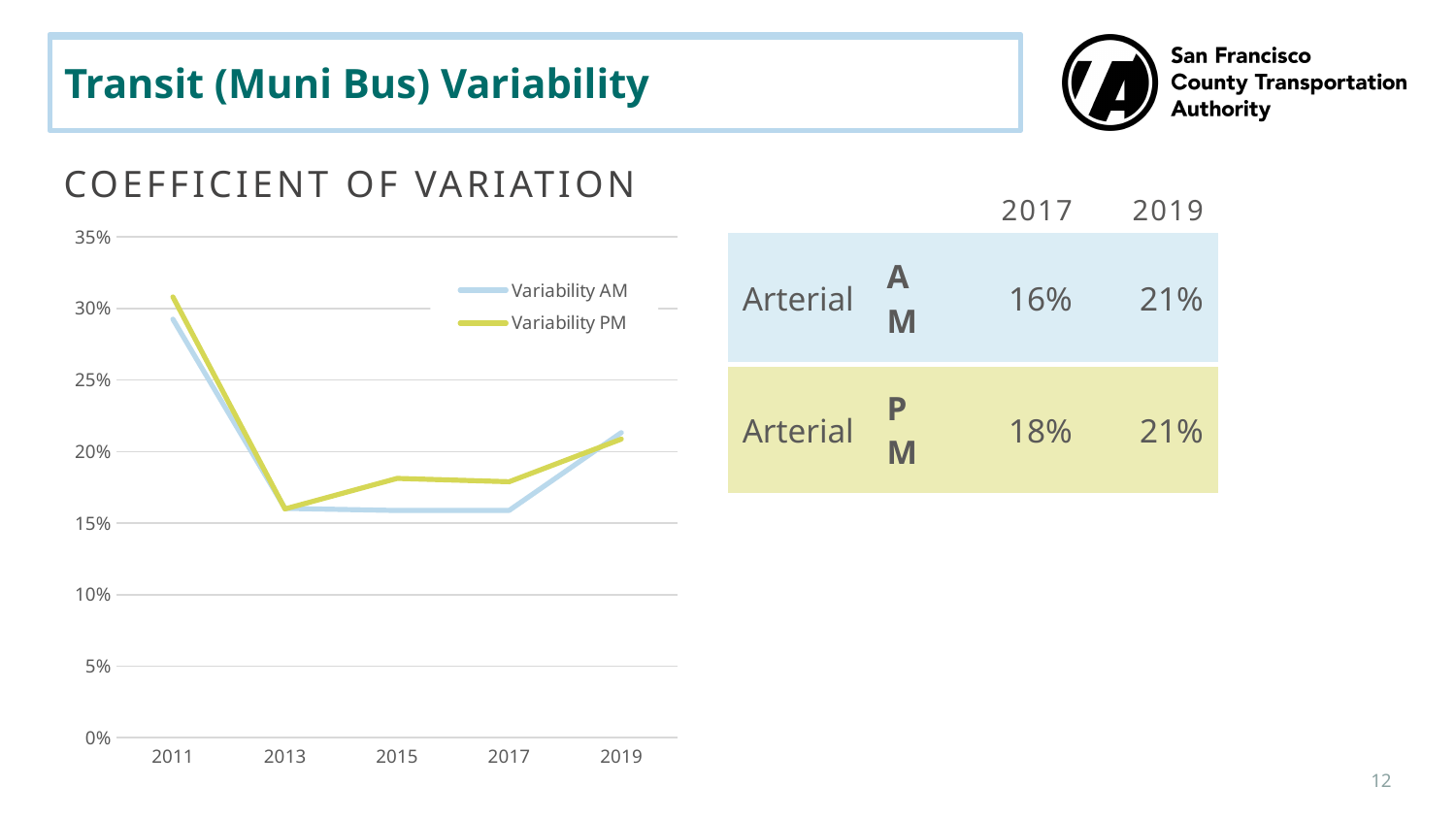
What kind of chart is shown on the slide? line chart Is the Variability PM value for 2015 greater or less than 20%? less How many series does the chart legend list? 2 What is the title of the chart? COEFFICIENT OF VARIATION According to the table on the slide, what is the Arterial AM coefficient of variation for 2019? 21% How many years are shown along the x axis of the chart? 5 Is the Variability AM value for 2011 greater or less than 25%? greater Which series is drawn in the yellow-green line? Variability PM In which year does the Variability PM line reach its lowest value? 2013 In 2011, which series has the higher value, Variability AM or Variability PM? Variability PM In which year does the Variability PM line reach its highest value? 2011 Does the Variability AM line rise or fall between 2011 and 2013? fall